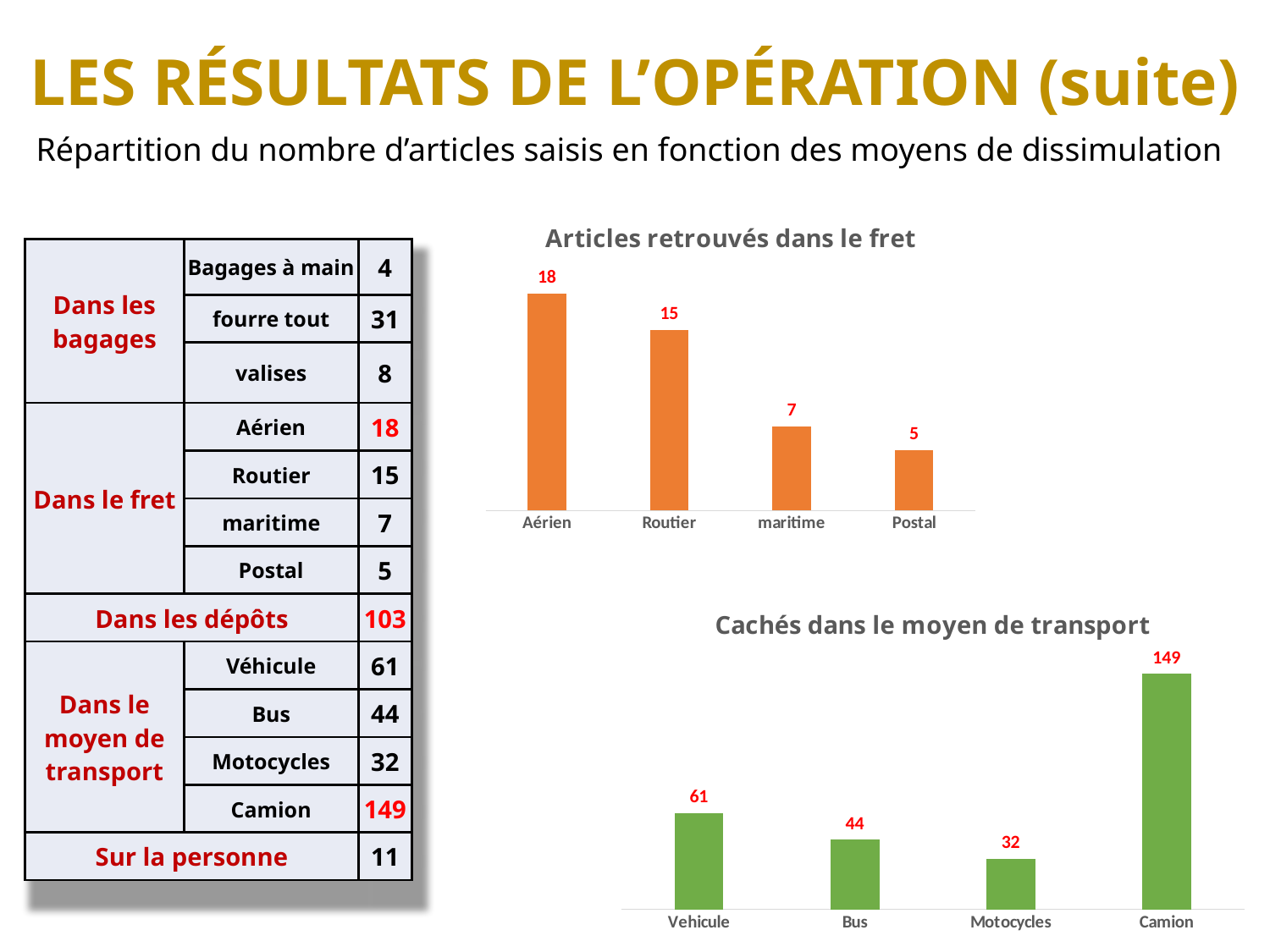
In the chart 'Cachés dans le moyen de transport', what is the value for Bus? 44 In the chart 'Articles retrouvés dans le fret', do the values rise or fall from left to right? Fall In the chart 'Articles retrouvés dans le fret', which category has the highest value? Aérien In the chart 'Articles retrouvés dans le fret', how many categories are shown? 4 In the chart 'Cachés dans le moyen de transport', which is larger, Vehicule or Bus? Vehicule In the chart 'Articles retrouvés dans le fret', what is the value for Postal? 5 What kind of chart is 'Cachés dans le moyen de transport'? Bar chart In the chart 'Cachés dans le moyen de transport', what is the difference between Camion and Vehicule? 88 In the chart 'Cachés dans le moyen de transport', which category has the lowest value? Motocycles In the chart 'Articles retrouvés dans le fret', what is the difference between Routier and maritime? 8 What colour are the bars in the chart 'Articles retrouvés dans le fret'? Orange In the chart 'Articles retrouvés dans le fret', what is the value for Aérien? 18